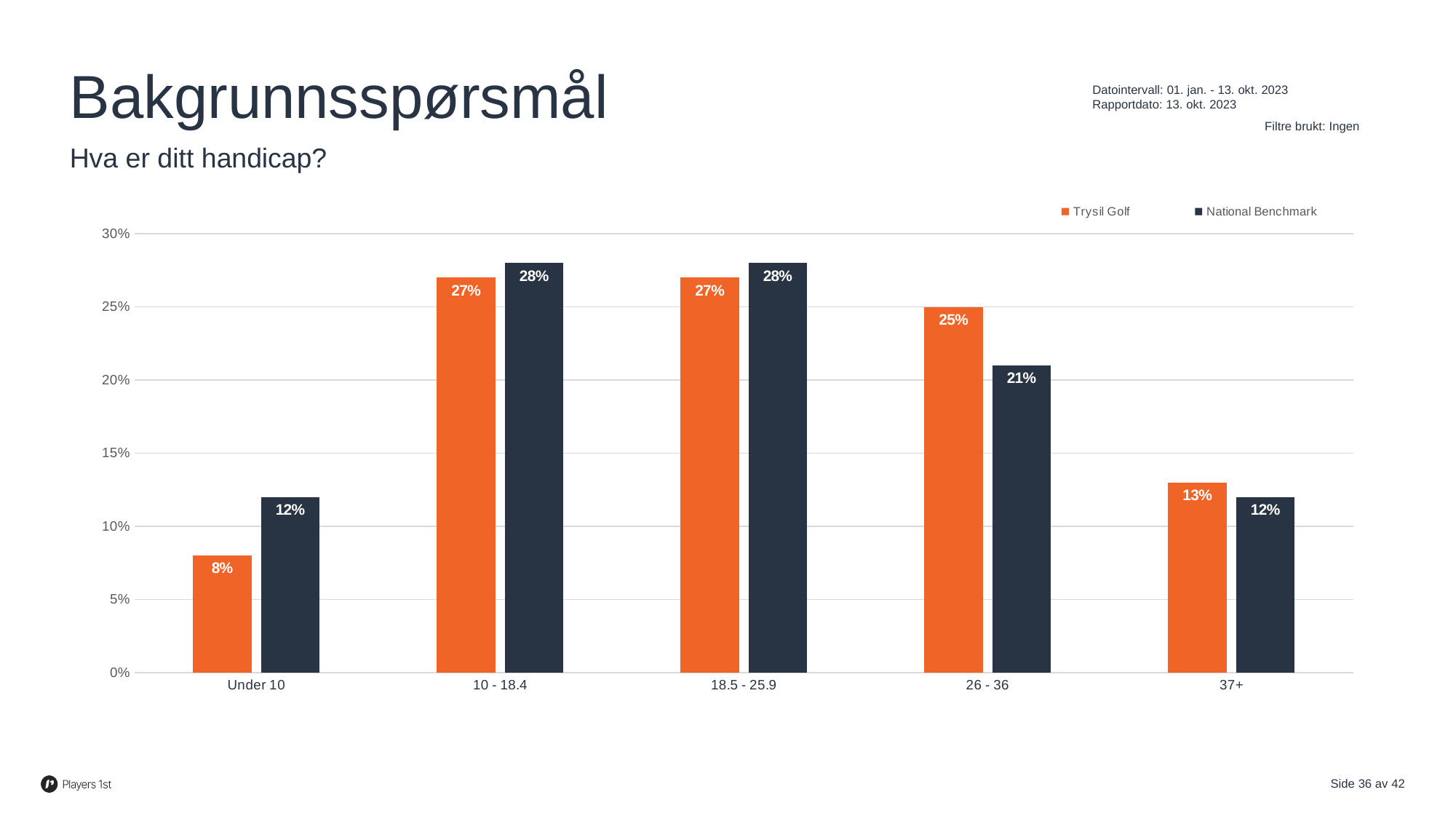
What is the National Benchmark value for the '26 - 36' handicap category? 21% What kind of chart is shown on the slide? Bar chart What is the difference between the Trysil Golf and National Benchmark values for the '26 - 36' category? 4 percentage points How many series does the legend list? 2 Is the Trysil Golf value for '10 - 18.4' greater or less than 25%? greater Which handicap category has the highest National Benchmark value? 10 - 18.4 and 18.5 - 25.9 (both 28%) Which handicap category has the lowest Trysil Golf value? Under 10 How many handicap categories are shown on the x axis? 5 Which colour represents Trysil Golf in the chart? Orange What is the Trysil Golf value for the 'Under 10' handicap category? 8% What is the Trysil Golf value for the '37+' handicap category? 13% For the 'Under 10' category, which series has the larger value, Trysil Golf or National Benchmark? National Benchmark